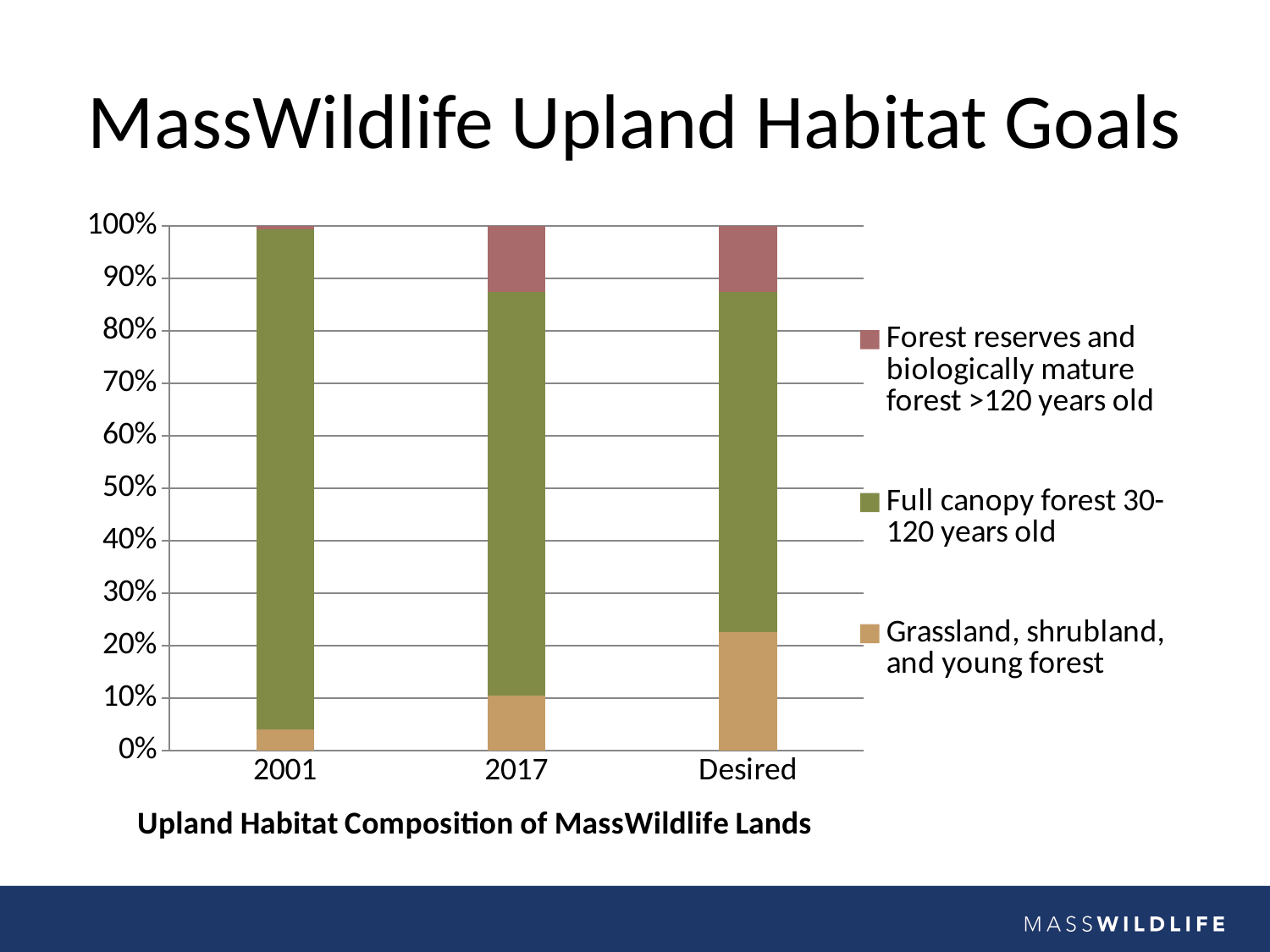
Is the value for Full canopy forest 30-120 years old in 2001 greater or less than 90%? greater Does the share of Grassland, shrubland, and young forest rise or fall from 2001 to 2017 to Desired? rise Which has a larger share of Grassland, shrubland, and young forest: 2001 or Desired? Desired What type of chart is shown on the slide? Stacked bar chart Is the value for Grassland, shrubland, and young forest in 2001 greater or less than 10%? less Which series is shown in the bottom segment of each stacked bar? Grassland, shrubland, and young forest How many categories are shown along the x axis of the chart? 3 What is the caption below the chart? Upland Habitat Composition of MassWildlife Lands Is the value for Grassland, shrubland, and young forest in the Desired bar greater or less than 20%? greater How many series does the chart's legend list? 3 What is the total of the stacked bar for 2017? 100%